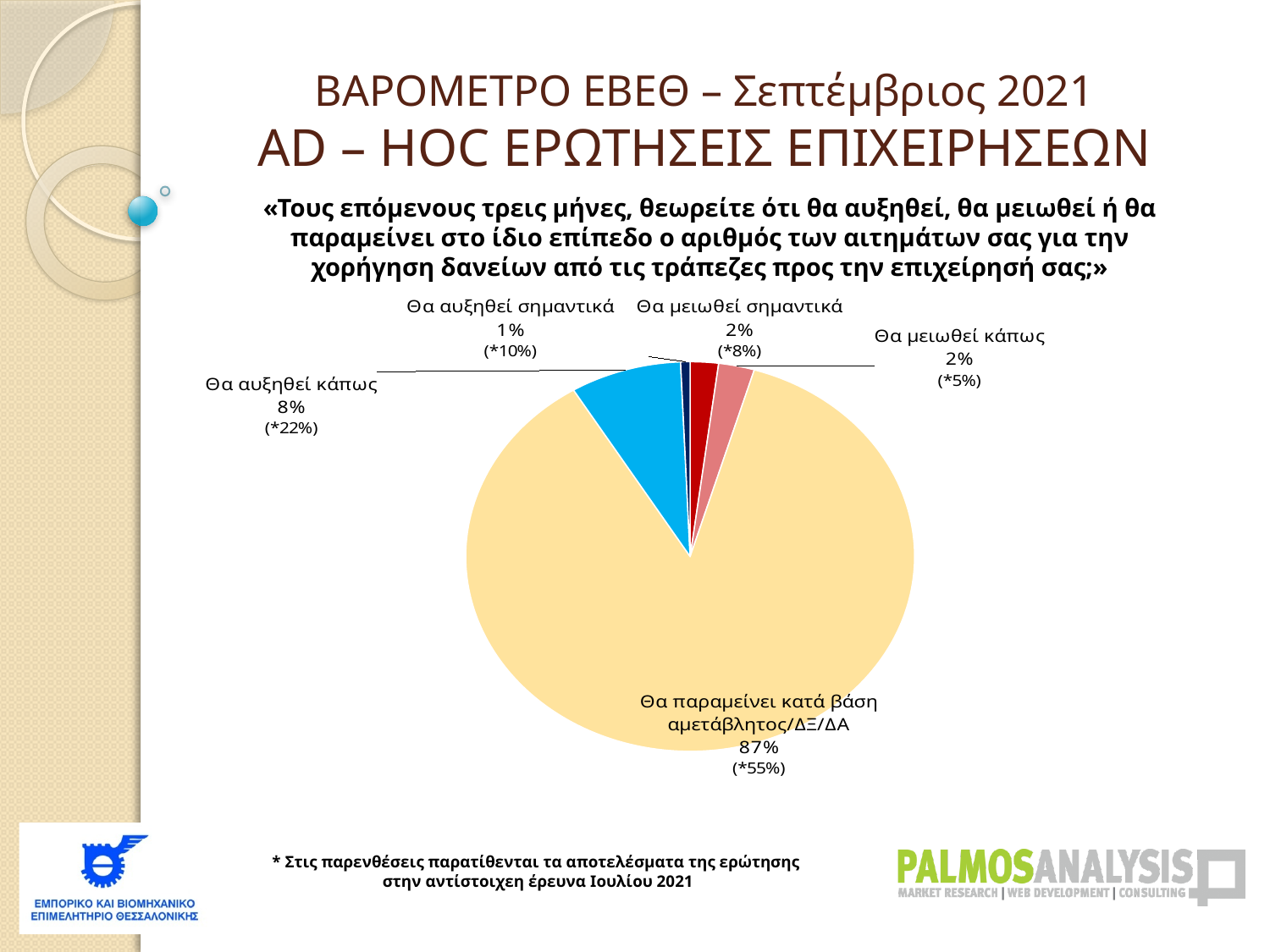
Which category has the largest slice of the pie? Θα παραμείνει κατά βάση αμετάβλητος/ΔΞ/ΔΑ Which is larger, the value for "Θα αυξηθεί κάπως" or the value for "Θα μειωθεί κάπως"? Θα αυξηθεί κάπως What is the value shown for "Θα μειωθεί σημαντικά"? 2% What share of the pie does "Θα παραμείνει κατά βάση αμετάβλητος/ΔΞ/ΔΑ" hold? 87% What is the value shown for "Θα αυξηθεί σημαντικά"? 1% Which category has the smallest slice of the pie? Θα αυξηθεί σημαντικά How many slices does the pie chart have? 5 What value in parentheses (July 2021 survey) is shown for "Θα παραμείνει κατά βάση αμετάβλητος/ΔΞ/ΔΑ"? *55% What is the difference between the values for "Θα παραμείνει κατά βάση αμετάβλητος/ΔΞ/ΔΑ" and "Θα αυξηθεί κάπως"? 79% What value in parentheses (July 2021 survey) is shown for "Θα αυξηθεί κάπως"? *22% What is the value shown for "Θα αυξηθεί κάπως"? 8% What kind of chart is shown on the slide? pie chart